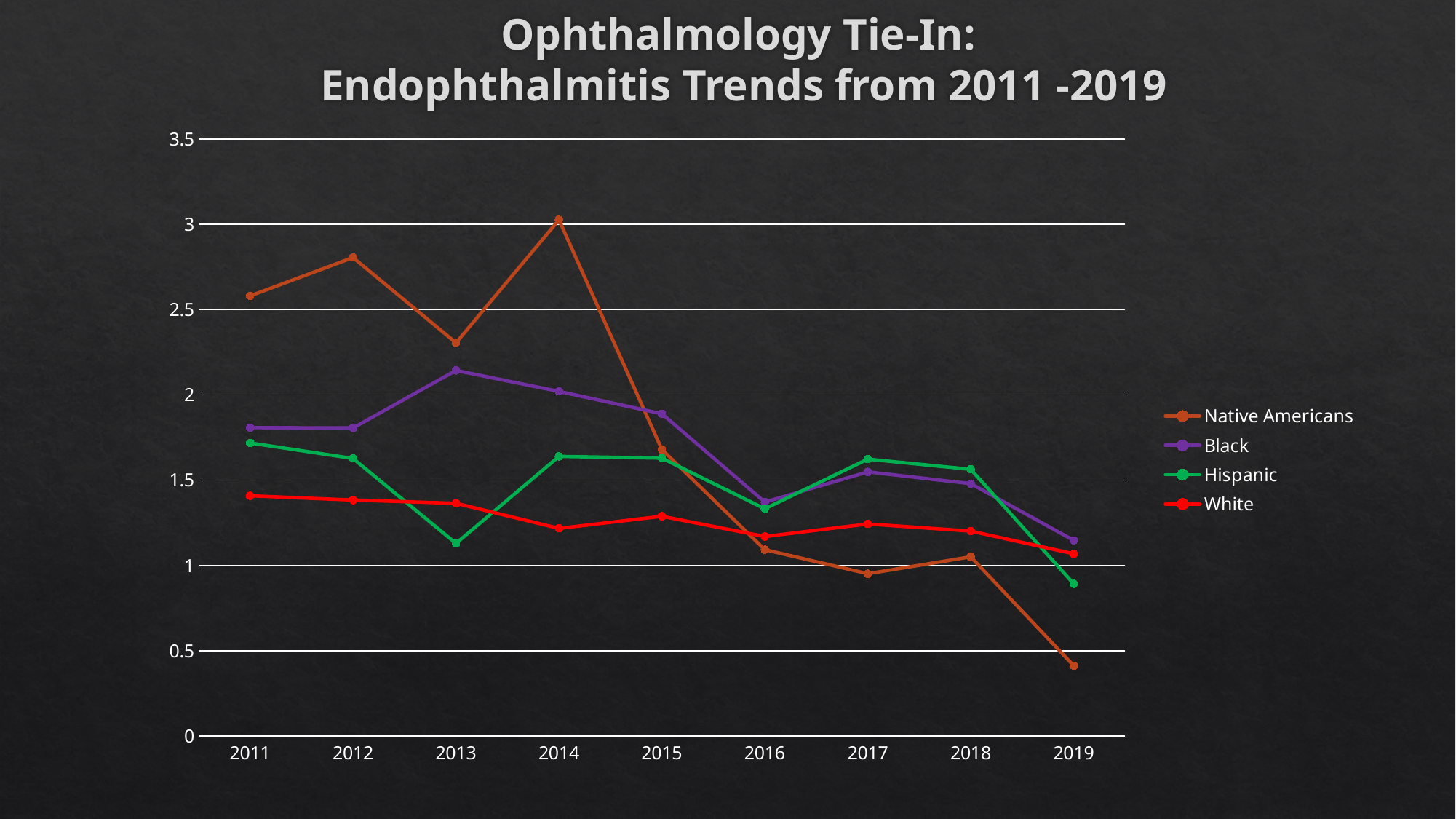
In 2013, which is larger: the value for Hispanic or the value for White? White How many series does the legend list? 4 Is the value for Native Americans in 2012 greater or less than 2.5? greater Is the value for Hispanic in 2019 greater or less than 1? less In which year does the Native Americans series reach its highest value? 2014 Which series has the highest value in 2014? Native Americans Does the Native Americans series rise or fall from 2014 to 2019? fall Is the value for Black in 2013 greater or less than 2? greater What kind of chart is shown on the slide? line chart Which series has the lowest value in 2019? Native Americans How many years are plotted along the x axis? 9 In which year is the Hispanic series at its lowest? 2019